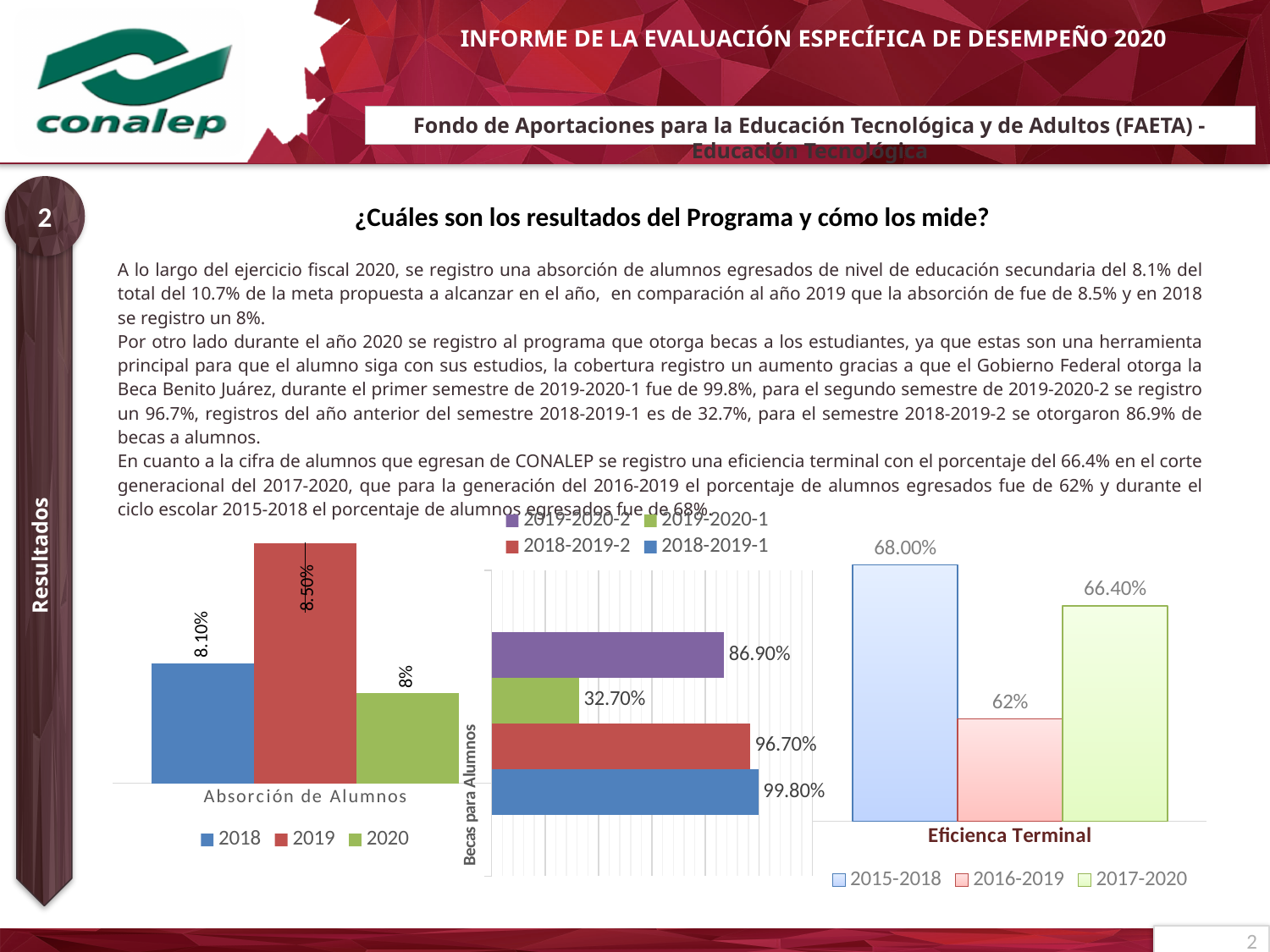
In the 'Becas para Alumnos' chart, what is the value for 2019-2020-1? 32.70% In the 'Absorción de Alumnos' chart, how many series does the legend list? 3 In the 'Absorción de Alumnos' chart, what is the value for 2019? 8.50% In the 'Eficienca Terminal' chart, which is larger, the value for 2015-2018 or the value for 2017-2020? 2015-2018 In the 'Becas para Alumnos' chart, what is the value for 2018-2019-1? 99.80% What kind of chart is the 'Eficienca Terminal' chart? Bar chart In the 'Eficienca Terminal' chart, what is the value for 2016-2019? 62% In the 'Absorción de Alumnos' chart, what is the value for 2018? 8.10% In the 'Absorción de Alumnos' chart, which year has the highest value? 2019 In the 'Becas para Alumnos' chart, which series has the lowest value? 2019-2020-1 In the 'Becas para Alumnos' chart, what is the difference between the values for 2018-2019-1 and 2018-2019-2? 3.10% In the 'Absorción de Alumnos' chart, which year has the lowest value? 2020